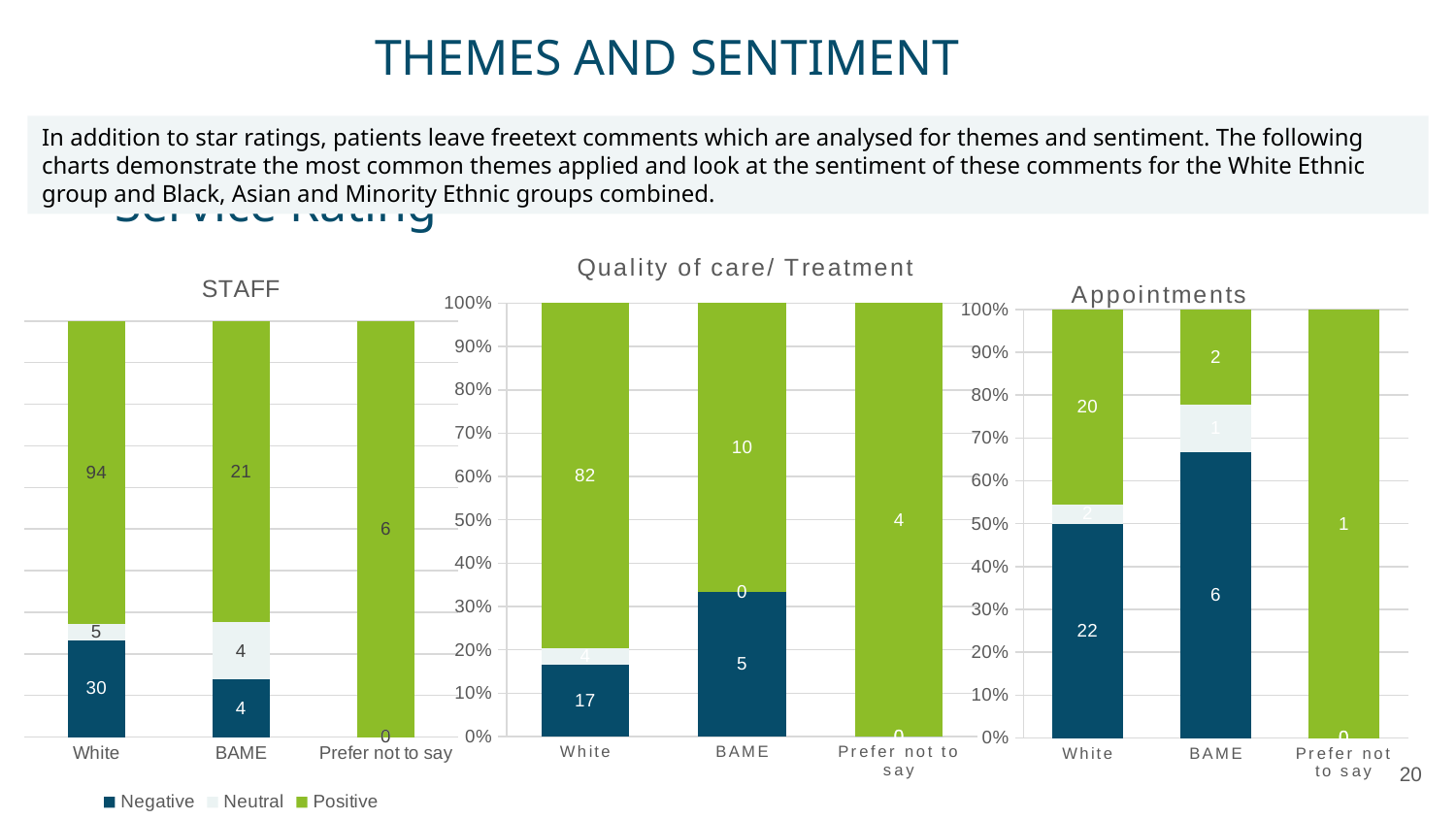
In the Quality of care/ Treatment chart, what is the Negative value for White? 17 In the Quality of care/ Treatment chart, what is the difference between the Positive value for White and the Positive value for BAME? 72 In the STAFF chart, what is the Negative value for BAME? 4 What kind of chart is the Appointments chart? Stacked bar chart In the Appointments chart, what is the Positive value for BAME? 2 In the STAFF chart, what is the total of the labelled values in the White bar? 129 In the STAFF chart, what is the Positive value for White? 94 In the Appointments chart, which is larger for White: the Negative value or the Positive value? Negative In the Appointments chart, what is the total of the labelled values in the BAME bar? 9 How many categories are shown on the x axis of the Quality of care/ Treatment chart? 3 In the Appointments chart, what is the Negative value for White? 22 How many series does the legend list? 3